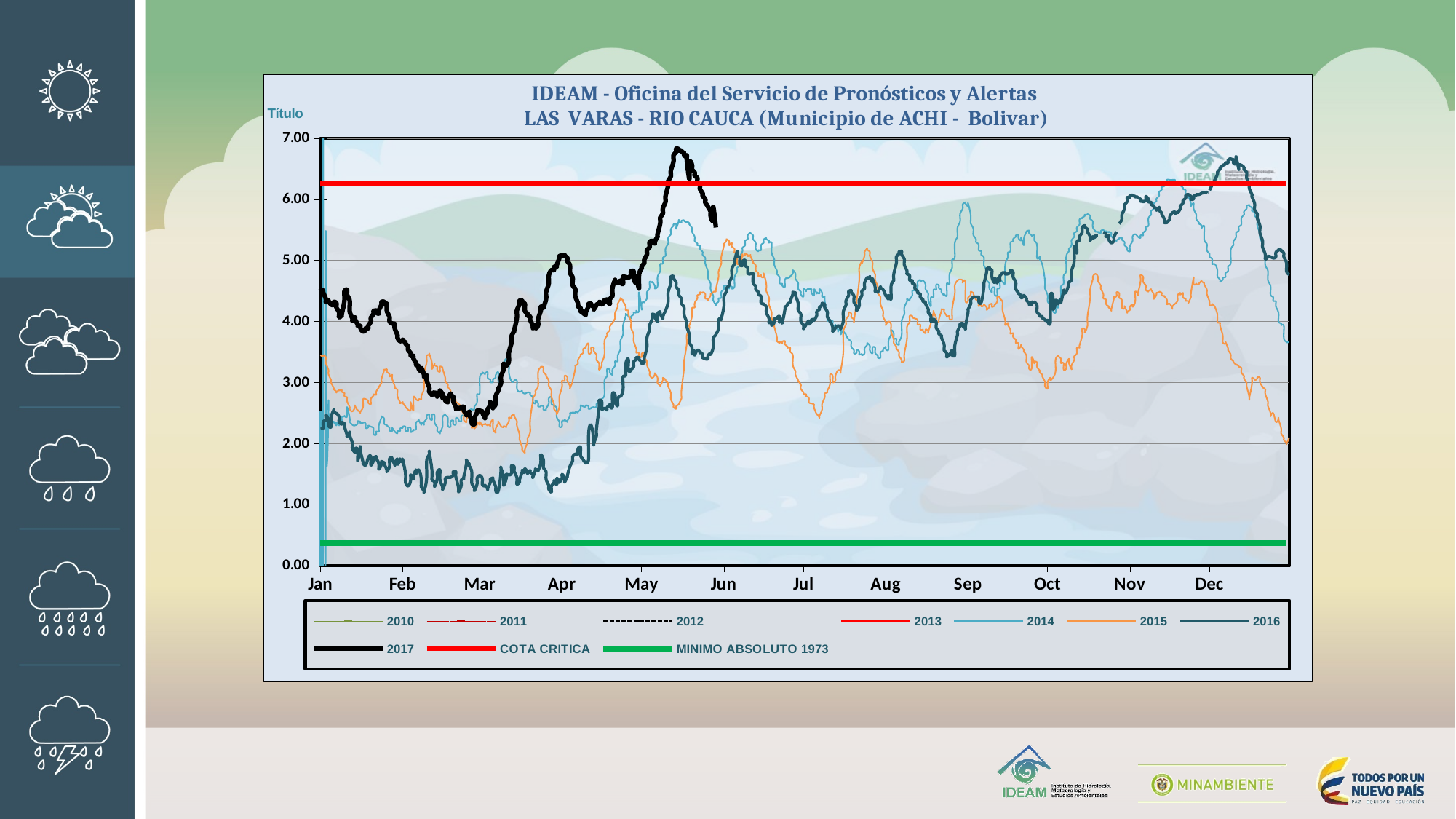
Does the 2017 series rise or fall between March and May? rise Is the peak value of the 2017 series in late May greater or less than 6.00? greater What colour is the COTA CRITICA line? red Is the COTA CRITICA line greater or less than 6.00? greater Which station and river does the chart title name? LAS VARAS - RIO CAUCA How many month labels are shown along the x axis? 12 How many entries does the chart legend list? 10 Is the value of the 2016 series in February greater or less than 2.00? less In February, which series has the larger value, 2017 or 2016? 2017 What kind of chart is shown on the slide? line chart